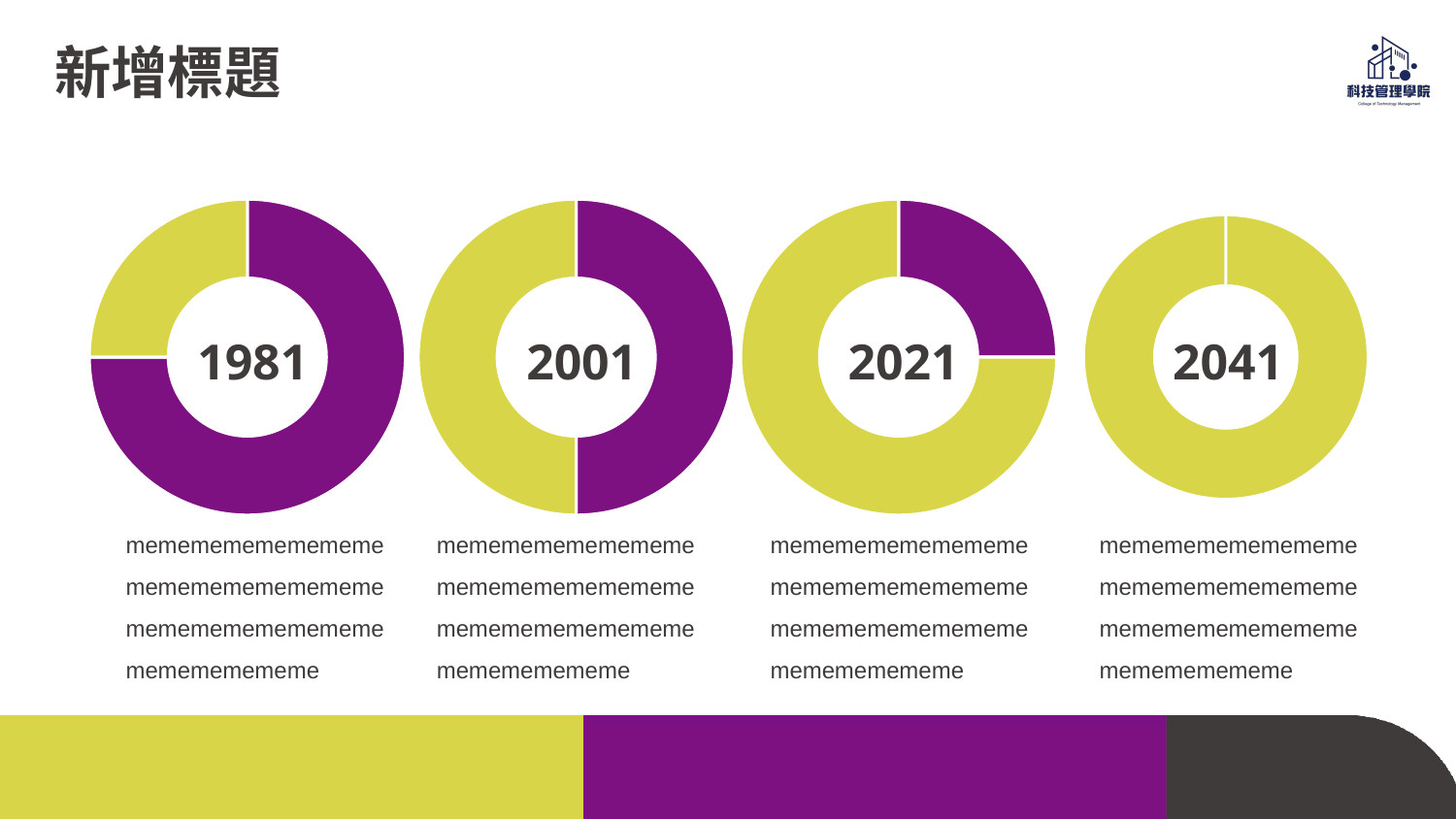
How many donut charts are on the slide? 4 In the 2021 donut chart, which slice is larger, the purple one or the yellow-green one? Yellow-green What two colours are used for the slices in the donut charts? Purple and yellow-green Which of the four donut charts has the largest purple slice? 1981 Across the donut charts from 1981 to 2041, does the purple share rise or fall? Fall What labels appear in the centres of the four donut charts, from left to right? 1981, 2001, 2021, 2041 In the 2041 donut chart, which colour fills almost the entire ring? Yellow-green Which of the four donut charts has the smallest purple slice? 2041 What kind of chart is shown for 1981? Donut (pie) chart Across the donut charts from 1981 to 2041, does the yellow-green share rise or fall? Rise In the 1981 donut chart, which slice is larger, the purple one or the yellow-green one? Purple How many slices does the 1981 donut chart have? 2